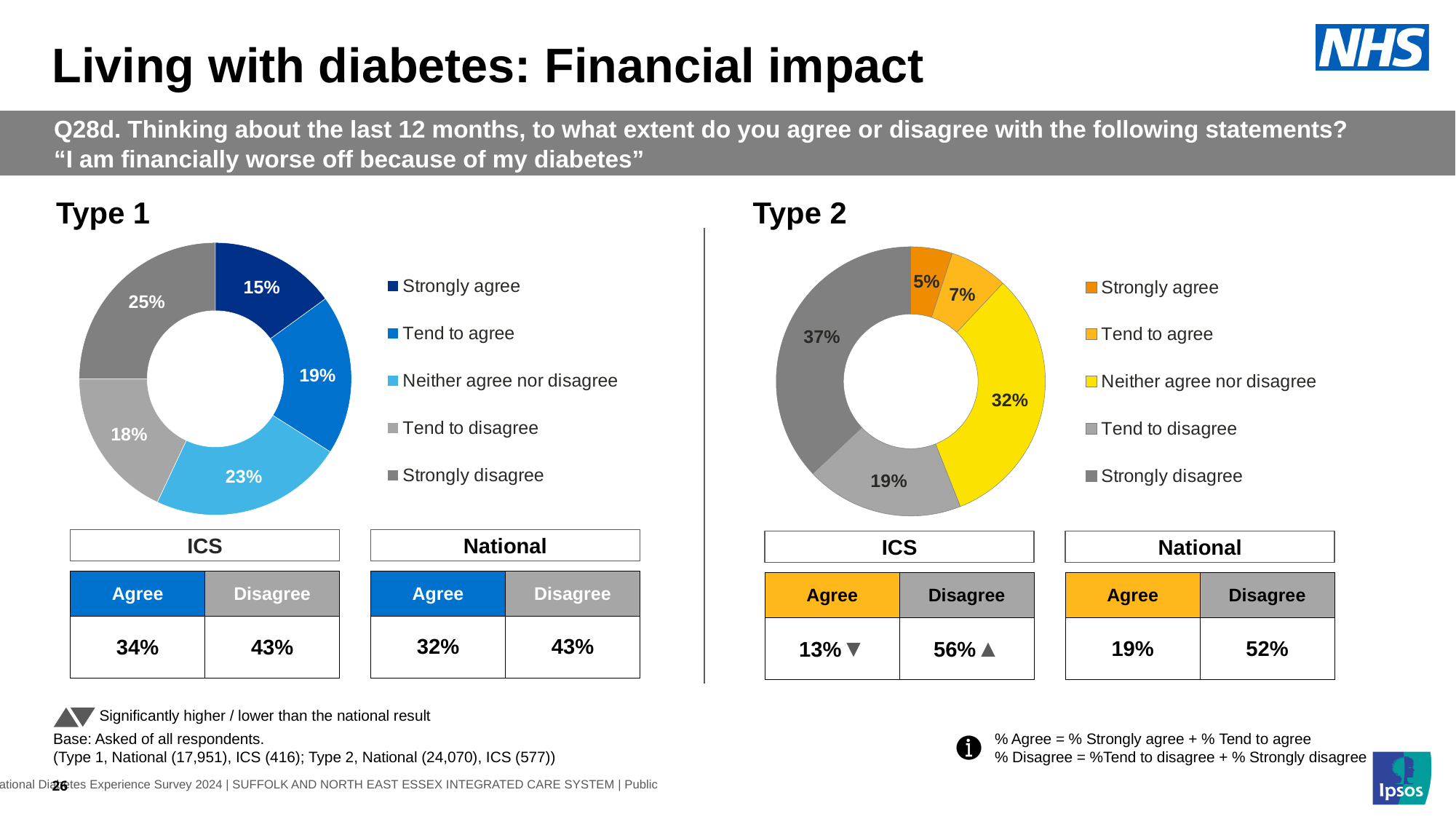
In the Type 1 chart, what percentage of respondents said 'Strongly agree'? 15% In the Type 1 chart, what percentage of respondents said 'Neither agree nor disagree'? 23% In the Type 2 chart, what is the difference between the 'Neither agree nor disagree' and 'Tend to disagree' percentages? 13 percentage points In the Type 1 chart, what is the difference between the 'Strongly disagree' and 'Tend to disagree' percentages? 7 percentage points In the Type 2 chart, what percentage of respondents said 'Tend to agree'? 7% In the Type 2 chart, which is larger: 'Strongly disagree' or 'Neither agree nor disagree'? Strongly disagree In the Type 2 chart, what percentage of respondents said 'Strongly disagree'? 37% In the Type 2 chart, what colour is the 'Neither agree nor disagree' segment? Yellow In the Type 2 chart, which response category has the smallest share? Strongly agree How many response categories does the Type 1 chart's legend list? 5 In the Type 1 chart, which response category has the largest share? Strongly disagree What kind of chart is used for Type 2? Donut (pie) chart